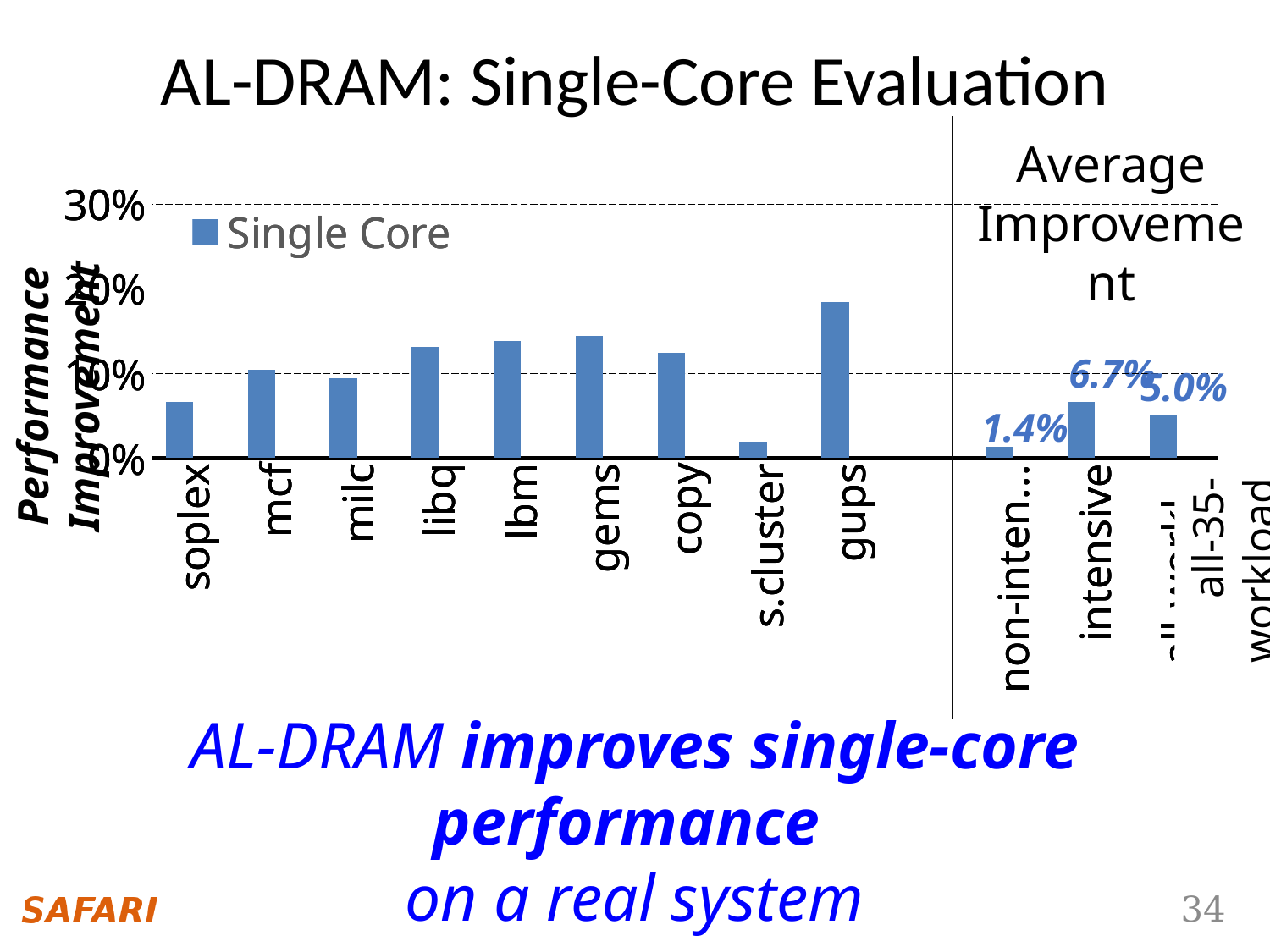
Which benchmark has the lowest single-core performance improvement? s.cluster What type of chart is shown on the slide? bar chart Which benchmark has the highest single-core performance improvement? gups What is the average performance improvement for the non-intensive workloads? 1.4% Which has a larger average improvement, intensive or non-intensive workloads? intensive How many series does the legend list? 1 What is the difference between the intensive and all-35-workload average improvements? 1.7% What is the legend entry shown on the chart? Single Core What is the average performance improvement for the intensive workloads? 6.7% What is the average performance improvement for the all-35-workload category? 5.0% Is the performance improvement for gups greater or less than 10%? greater Is the performance improvement for soplex greater or less than 10%? less